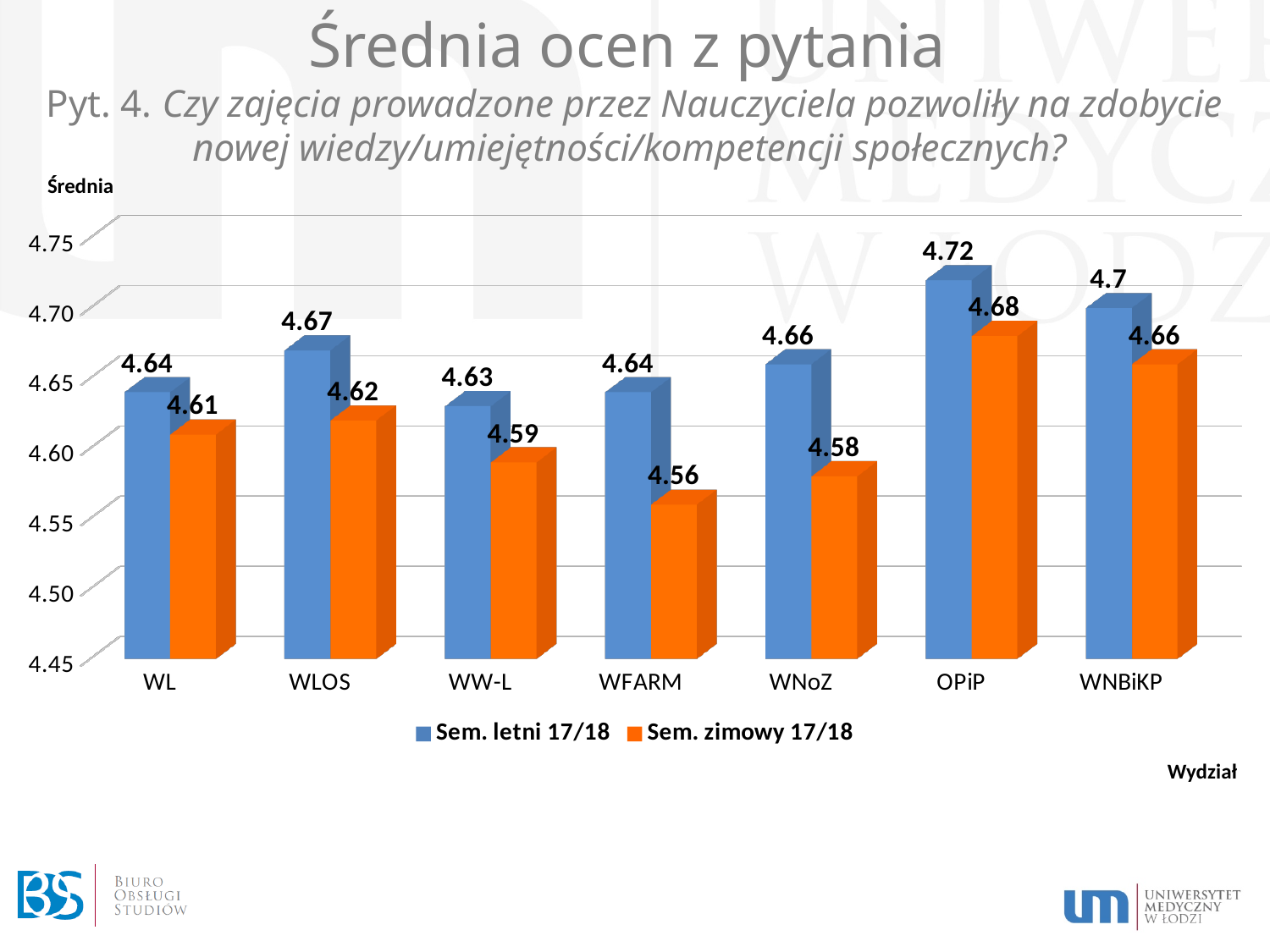
What is the difference between the Sem. letni 17/18 and Sem. zimowy 17/18 values for WFARM? 0.08 Which is larger for WNoZ: the Sem. letni 17/18 value or the Sem. zimowy 17/18 value? Sem. letni 17/18 What is the value for WFARM in the Sem. zimowy 17/18 series? 4.56 What kind of chart is shown on the slide? bar chart How many categories are shown on the x axis? 7 What is the value for WLOS in the Sem. letni 17/18 series? 4.67 Which category has the highest value in the Sem. letni 17/18 series? OPiP What is the label of the vertical axis? Średnia Is the Sem. zimowy 17/18 value for WL greater or less than 4.65? less What is the value for OPiP in the Sem. zimowy 17/18 series? 4.68 How many series does the legend list? 2 Which category has the lowest value in the Sem. zimowy 17/18 series? WFARM